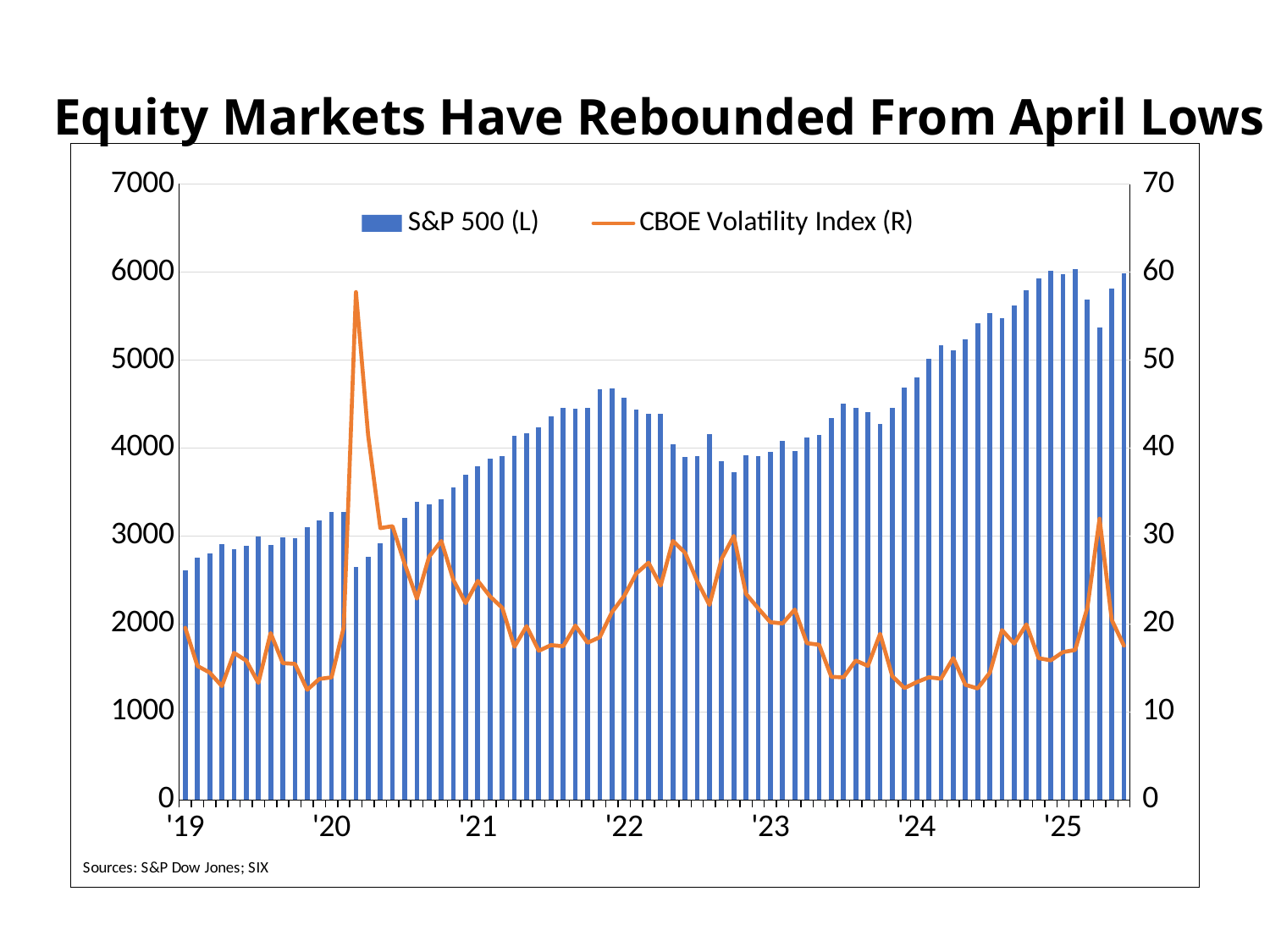
Is the CBOE Volatility Index value at the start of 2024 greater or less than 20? less In which year does the CBOE Volatility Index reach its highest value? 2020 Which series is plotted as a line? CBOE Volatility Index (R) Is the peak value of the CBOE Volatility Index in 2020 greater or less than 50? greater How many series does the legend list? 2 Is the S&P 500 value at the start of 2019 greater or less than 3000? less Which series is plotted as bars? S&P 500 (L) Does the S&P 500 generally rise or fall from 2019 to 2025? rise What is the maximum value shown on the left axis? 7000 What kind of chart is shown on the slide? A combination bar and line chart Which is larger, the S&P 500 value at the start of 2019 or at the start of 2025? Start of 2025